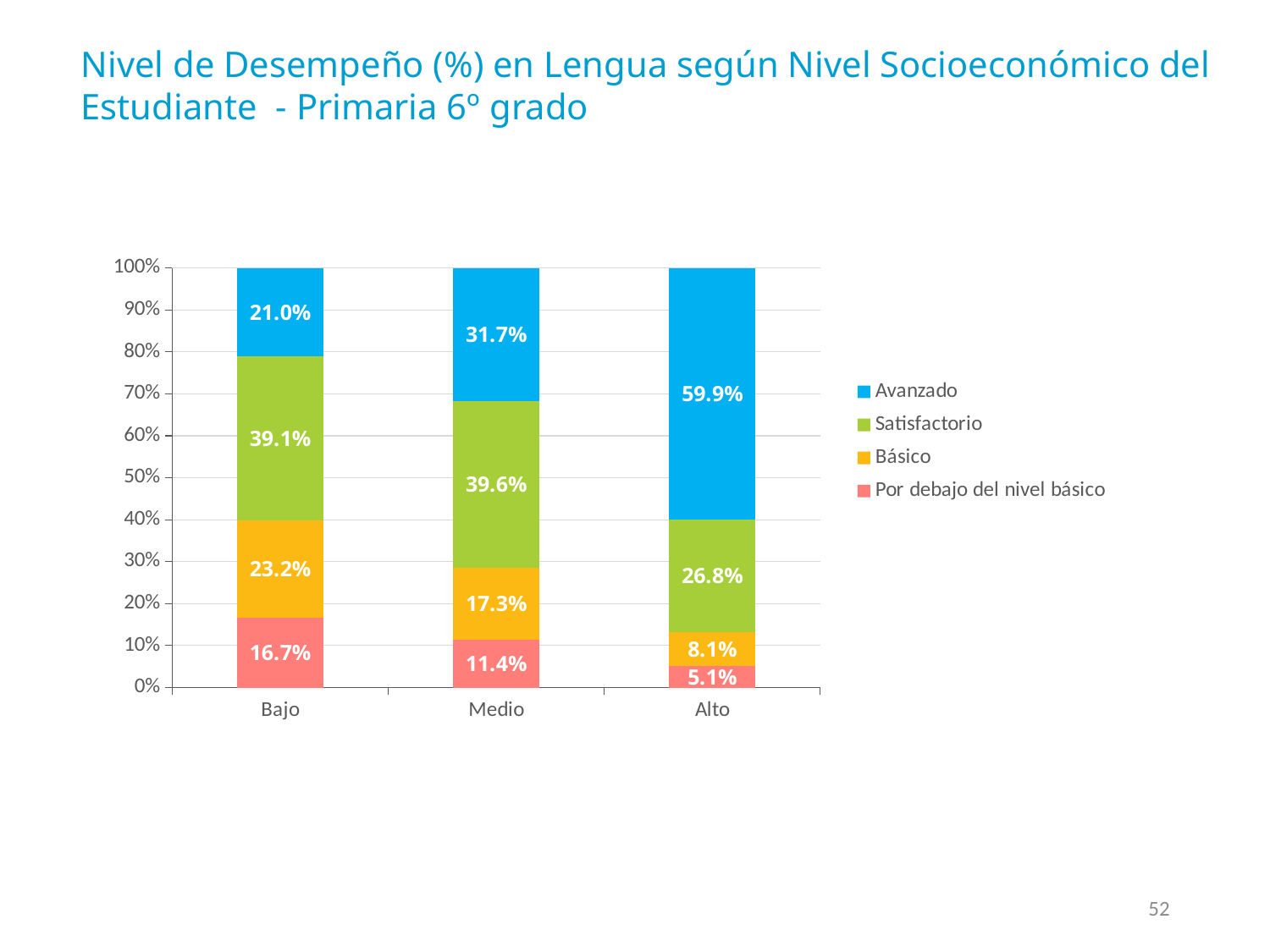
How many series does the legend list? 4 Which is larger, the Básico value for Bajo or the Básico value for Medio? Bajo Which category has the highest value for Avanzado? Alto Does the Avanzado value rise or fall from Bajo to Alto? Rise What is the difference between the Avanzado values for Alto and Bajo? 38.9% Which category has the lowest value for Por debajo del nivel básico? Alto What is the value for Avanzado in the Alto category? 59.9% What is the value for Por debajo del nivel básico in the Bajo category? 16.7% What is the value for Satisfactorio in the Alto category? 26.8% How many categories are shown on the x axis? 3 What is the value for Básico in the Medio category? 17.3% What kind of chart is shown on the slide? Stacked bar chart